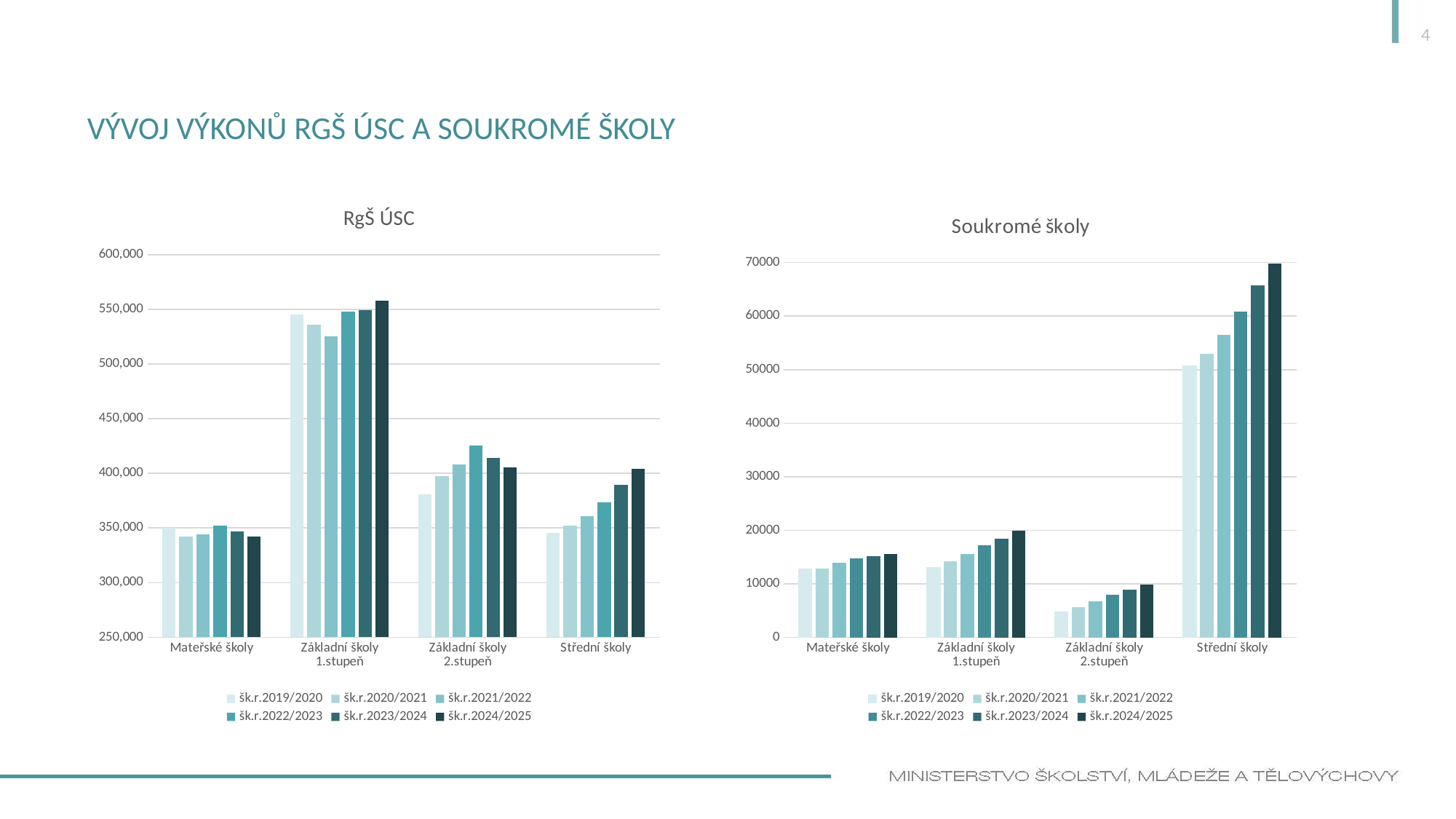
In the Soukromé školy chart, which category has the highest values? Střední školy In the Soukromé školy chart, is the value for Střední školy in šk.r.2024/2025 greater or less than 60000? greater In the RgŠ ÚSC chart, which is larger in šk.r.2019/2020: Základní školy 1.stupeň or Základní školy 2.stupeň? Základní školy 1.stupeň How many series does the legend of the Soukromé školy chart list? 6 In the Soukromé školy chart, which category has the lowest values? Základní školy 2.stupeň In the RgŠ ÚSC chart, is the value for Základní školy 1.stupeň in šk.r.2024/2025 greater or less than 550,000? greater In the RgŠ ÚSC chart, which category has the highest values? Základní školy 1.stupeň In the Soukromé školy chart, do the values for Střední školy rise or fall from šk.r.2019/2020 to šk.r.2024/2025? rise How many categories are shown on the x axis of the RgŠ ÚSC chart? 4 In the RgŠ ÚSC chart, is the value for Střední školy in šk.r.2023/2024 greater or less than 400,000? less What kind of chart is the Soukromé školy chart? bar chart